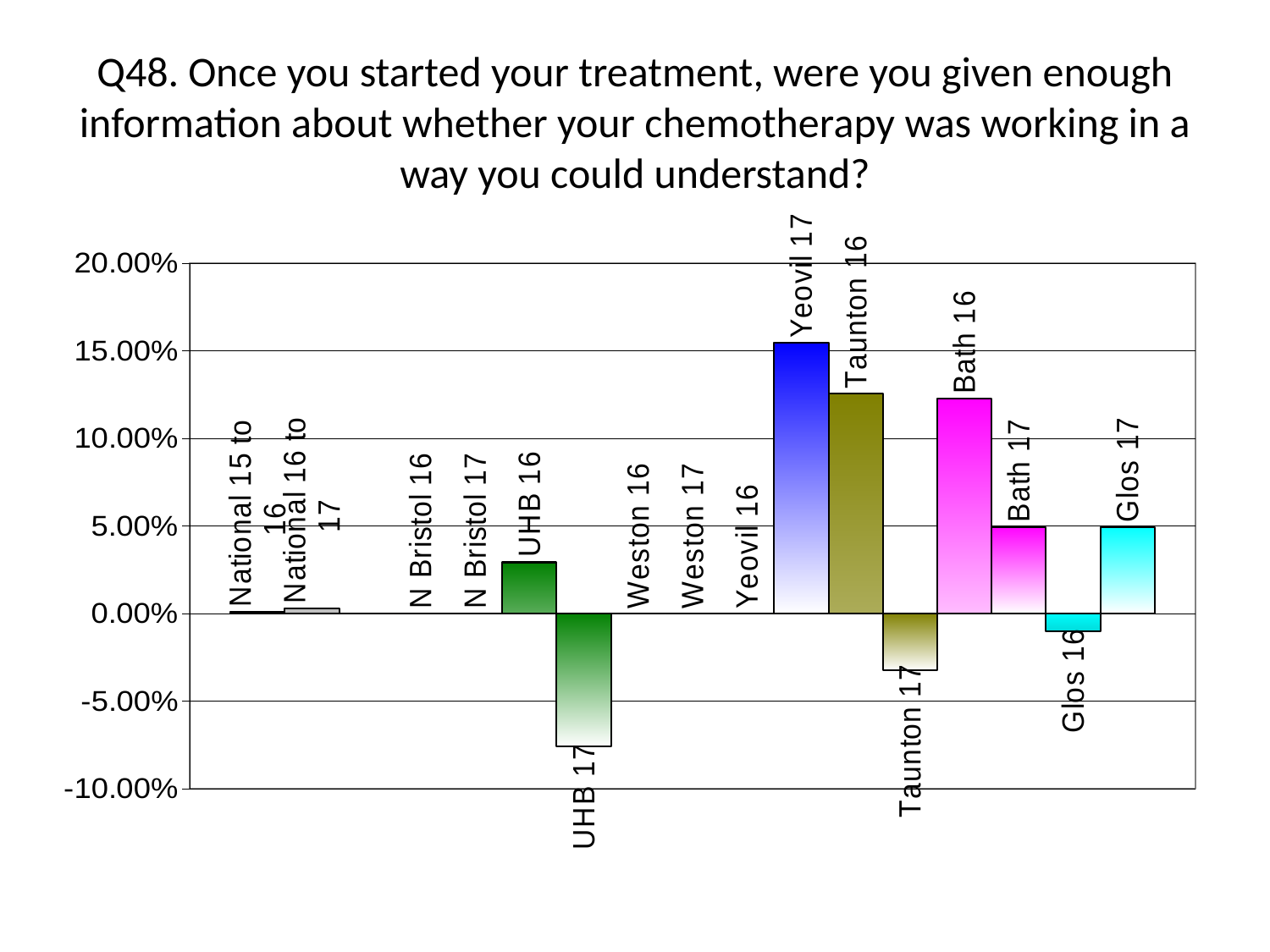
What is the highest value shown on the vertical axis? 20.00% Is the value for UHB 16 greater or less than 5.00%? less Which is larger, the value for Yeovil 17 or the value for Taunton 16? Yeovil 17 Which category has the lowest value? UHB 17 Is the value for Taunton 16 greater or less than 10.00%? greater Is the value for Yeovil 17 greater or less than 10.00%? greater Which is lower, the value for UHB 17 or the value for Taunton 17? UHB 17 Which category has the highest value? Yeovil 17 What kind of chart is shown on the slide? bar chart